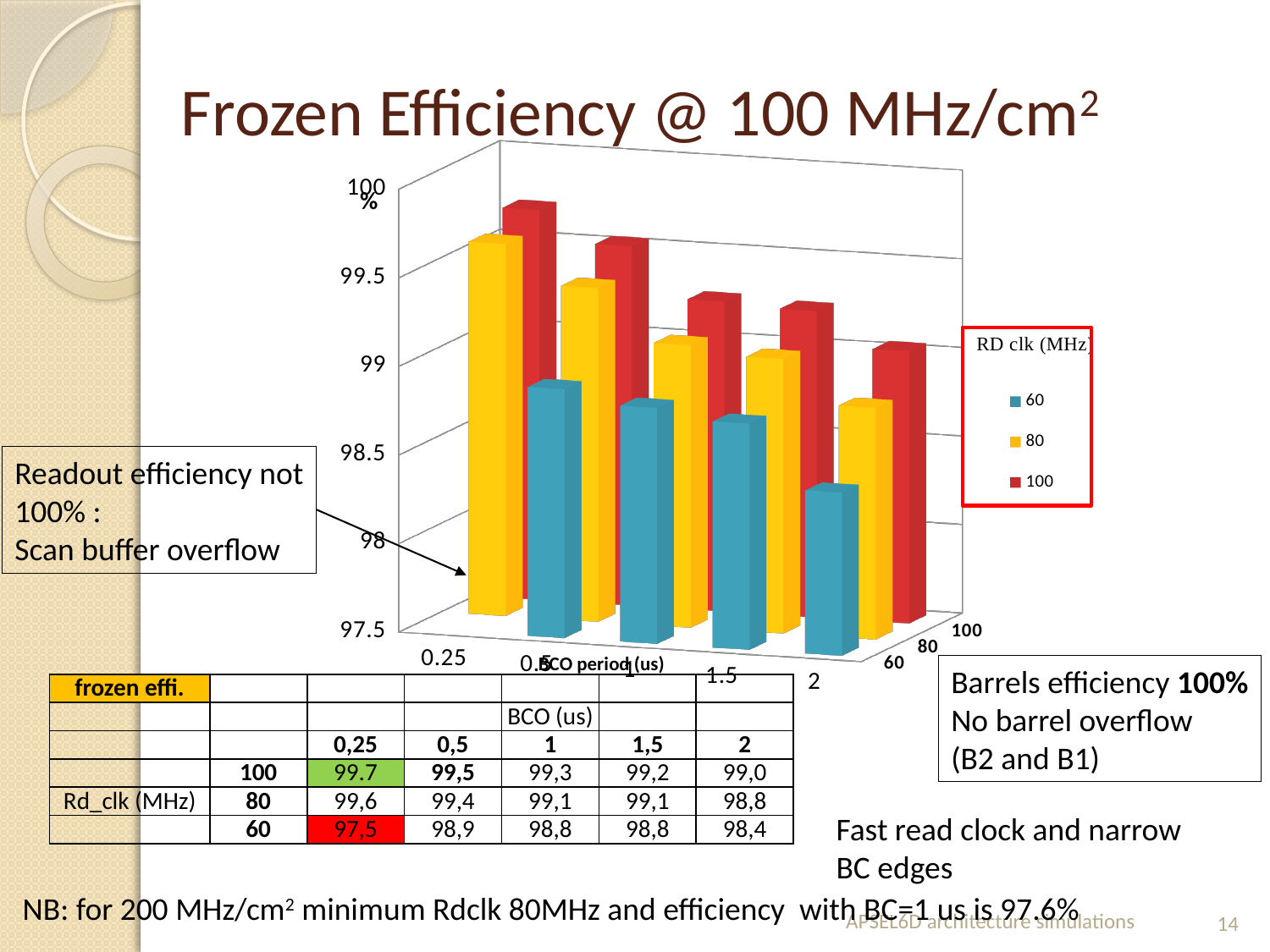
What is the difference between the efficiency for RD clk 100 MHz and RD clk 60 MHz at a BCO period of 0.25 us? 2.2 What is the frozen efficiency for RD clk 80 MHz at a BCO period of 2 us? 98,8 At a BCO period of 0.25 us, which RD clk series has the highest efficiency? 100 What kind of chart is shown on the slide? bar chart At a BCO period of 0.5 us, which is larger: the efficiency for RD clk 80 MHz or for RD clk 60 MHz? 80 MHz How many series does the chart legend list? 3 How many BCO period categories are plotted along the x axis of the chart? 5 At a BCO period of 2 us, which RD clk series has the lowest efficiency? 60 What is the title of the chart legend? RD clk (MHz) For the RD clk 100 MHz series, do the efficiency values rise or fall as the BCO period increases? fall What is the frozen efficiency for RD clk 100 MHz at a BCO period of 0.25 us? 99.7 What is the frozen efficiency for RD clk 60 MHz at a BCO period of 0.25 us? 97,5